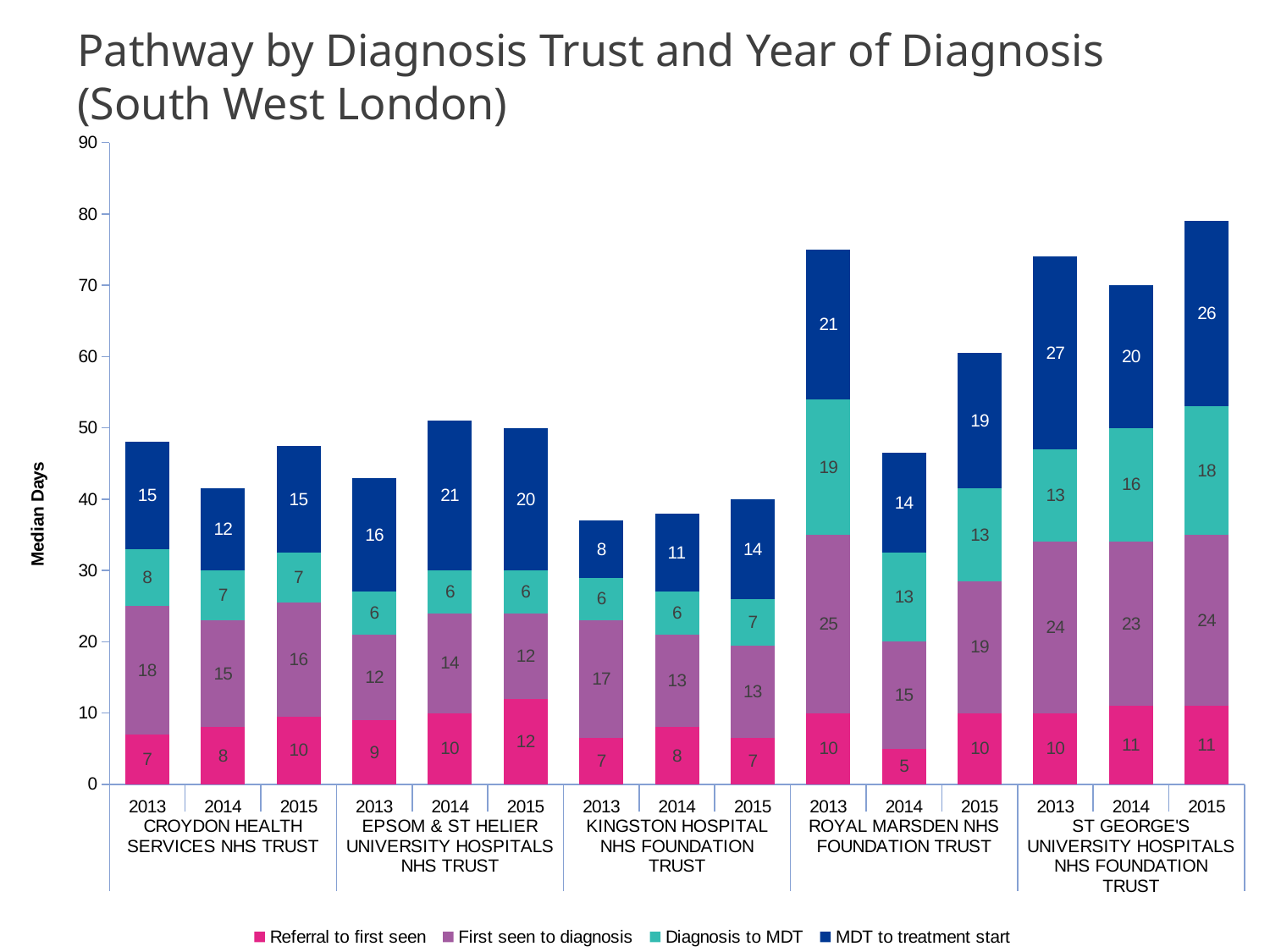
What is the total of the stacked bar for Royal Marsden NHS Foundation Trust in 2013? 75 What is the MDT to treatment start value for St George's University Hospitals NHS Foundation Trust in 2013? 27 Is the total of the stacked bar for Kingston Hospital NHS Foundation Trust in 2013 greater or less than 40? less What is the Referral to first seen value for Royal Marsden NHS Foundation Trust in 2014? 5 Which trust and year has the tallest stacked bar overall? St George's University Hospitals NHS Foundation Trust, 2015 Which is larger: the First seen to diagnosis value for Croydon Health Services NHS Trust in 2013 or for Kingston Hospital NHS Foundation Trust in 2013? Croydon Health Services NHS Trust 2013 How many series does the legend list? 4 What kind of chart is shown on the slide? Stacked bar chart Which trust and year has the lowest Referral to first seen value? Royal Marsden NHS Foundation Trust, 2014 How many trusts are shown on the x axis? 5 What is the difference between the Diagnosis to MDT value for Royal Marsden NHS Foundation Trust in 2013 and for Croydon Health Services NHS Trust in 2013? 11 What is the Diagnosis to MDT value for Epsom & St Helier University Hospitals NHS Trust in 2014? 6